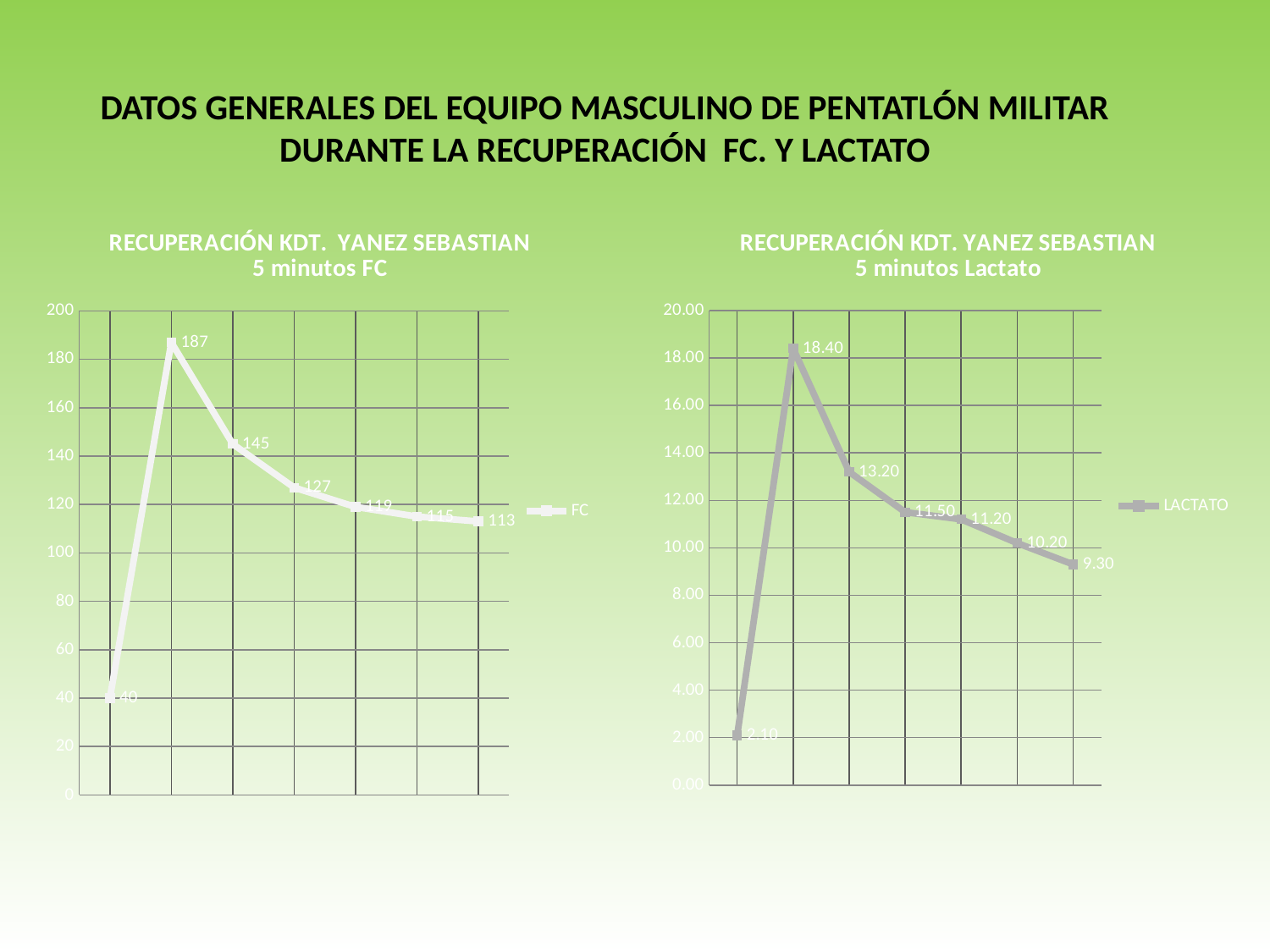
In the '5 minutos FC' chart on the left, how many data points are plotted? 7 In the '5 minutos FC' chart on the left, what is the value of the last data point? 113 In the '5 minutos FC' chart on the left, what is the difference between the highest value (187) and the first value (40)? 147 In the '5 minutos Lactato' chart on the right, what is the difference between the third value (13.20) and the fourth value (11.50)? 1.70 In the '5 minutos FC' chart on the left, what is the highest value plotted? 187 In the '5 minutos Lactato' chart on the right, what is the value of the first data point? 2.10 In the '5 minutos Lactato' chart on the right, do the values rise or fall from the second data point to the last? Fall In the '5 minutos Lactato' chart on the right, what is the value of the last data point? 9.30 In the '5 minutos Lactato' chart on the right, what is the highest value plotted? 18.40 What series name does the legend of the '5 minutos Lactato' chart on the right show? LACTATO What type of chart is the '5 minutos FC' chart on the left? Line chart In the '5 minutos FC' chart on the left, what is the lowest value plotted? 40